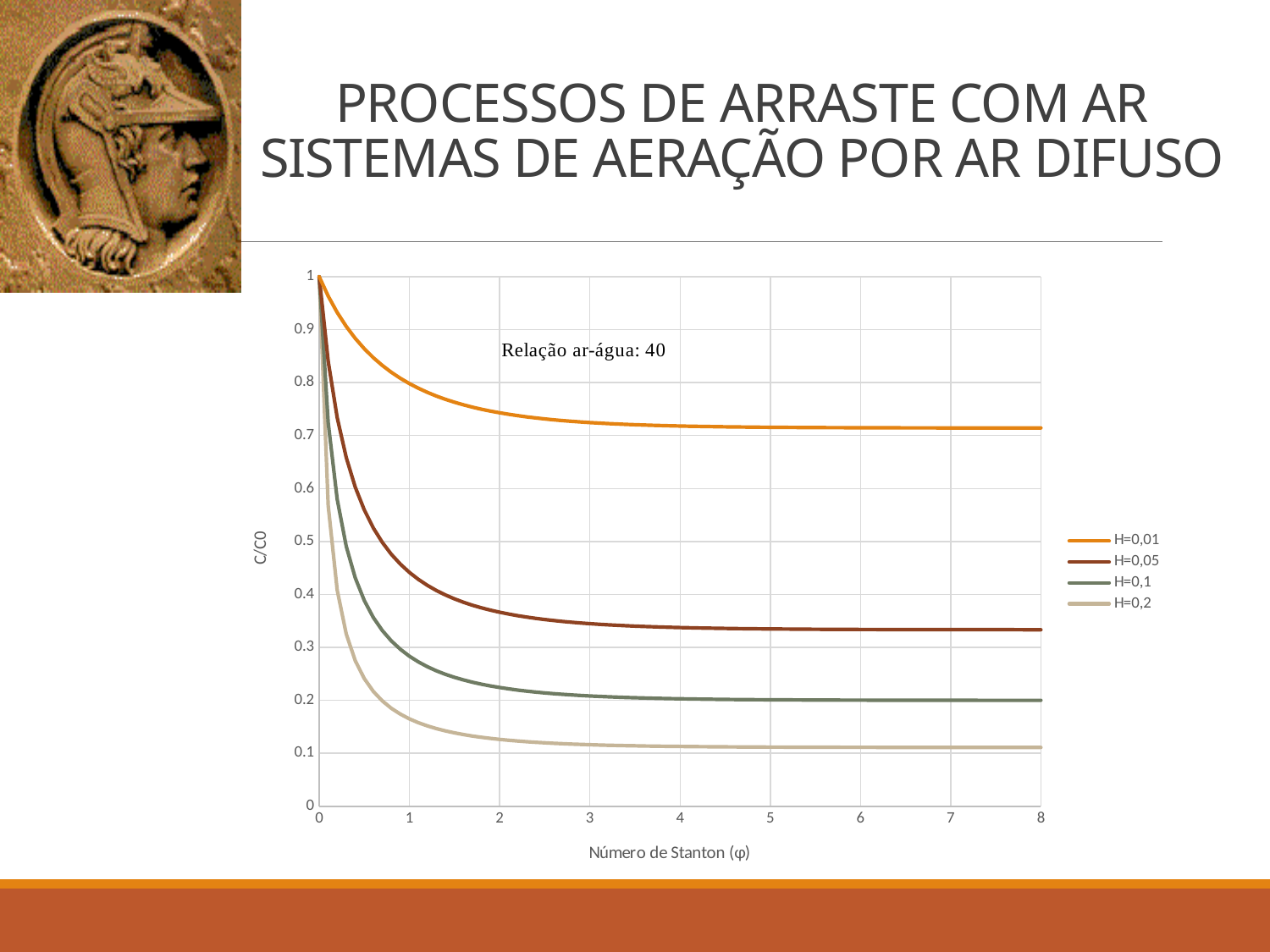
What air-water ratio (Relação ar-água) is stated in the annotation on the chart? 40 Is the C/C0 value for H=0,05 at φ = 8 greater or less than 0.4? less Is the C/C0 value for H=0,1 at φ = 8 greater or less than 0.3? less Is the C/C0 value for H=0,01 at φ = 8 greater or less than 0.6? greater How many series does the legend list? 4 Which series has the highest C/C0 value at φ = 4? H=0,01 At φ = 2, which series has the larger C/C0 value, H=0,05 or H=0,1? H=0,05 What kind of chart is shown on the slide? line chart What is the label of the x axis? Número de Stanton (φ) Do the C/C0 values rise or fall as the Número de Stanton (φ) increases? fall Which series has the lowest C/C0 value at φ = 4? H=0,2